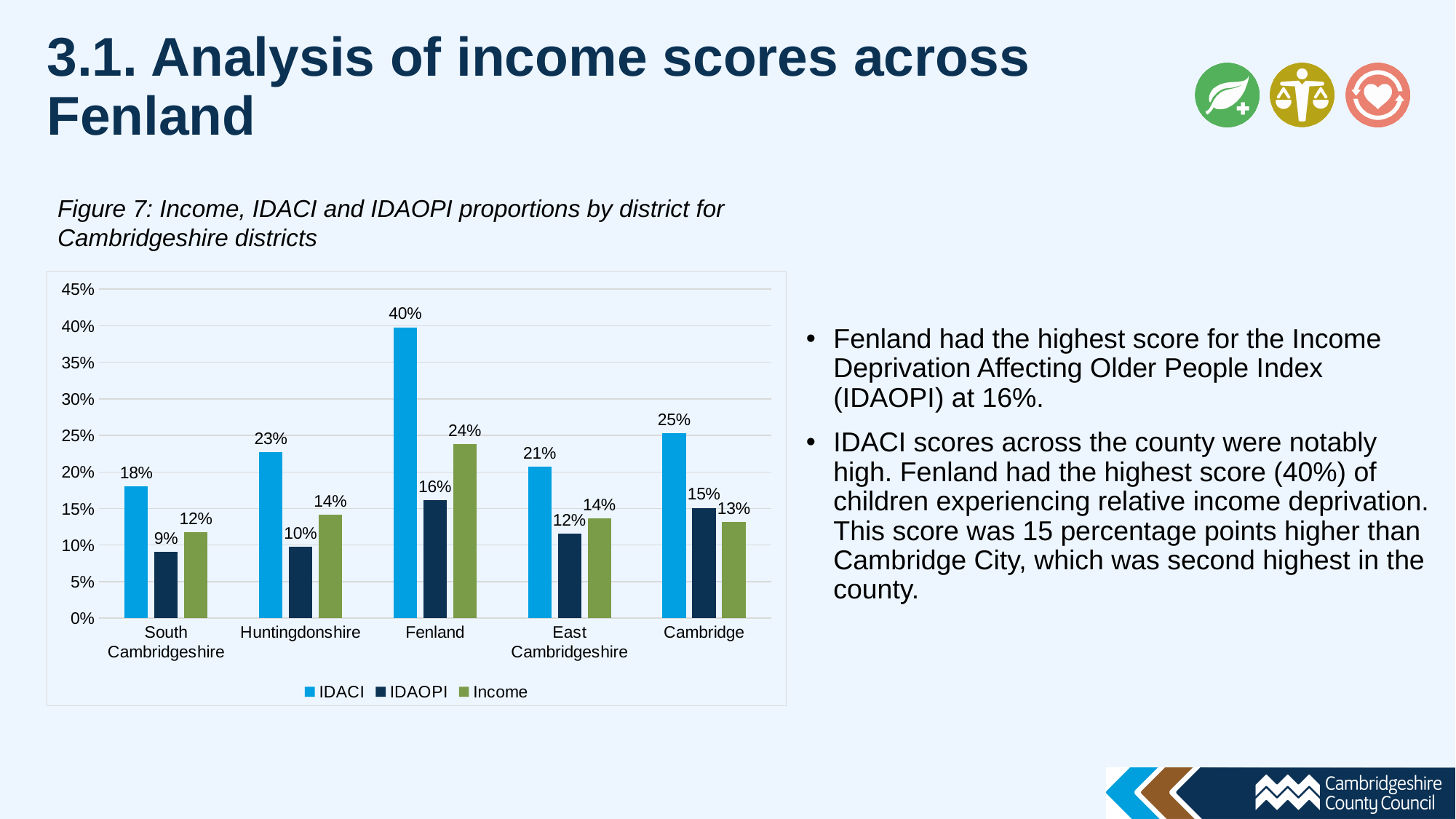
Which is larger, the Income value for Fenland or the Income value for Cambridge? Fenland Which district has the highest IDACI value? Fenland Is the IDACI value for Huntingdonshire greater or less than 20%? greater Which series is shown in light blue in the legend? IDACI How many districts are shown on the x axis? 5 How many series does the legend list? 3 What is the IDACI value for Fenland? 40% What is the Income value for Huntingdonshire? 14% Which district has the lowest IDAOPI value? South Cambridgeshire What is the difference between the IDACI values for Fenland and Cambridge? 15% What kind of chart is shown? Bar chart What is the IDAOPI value for South Cambridgeshire? 9%